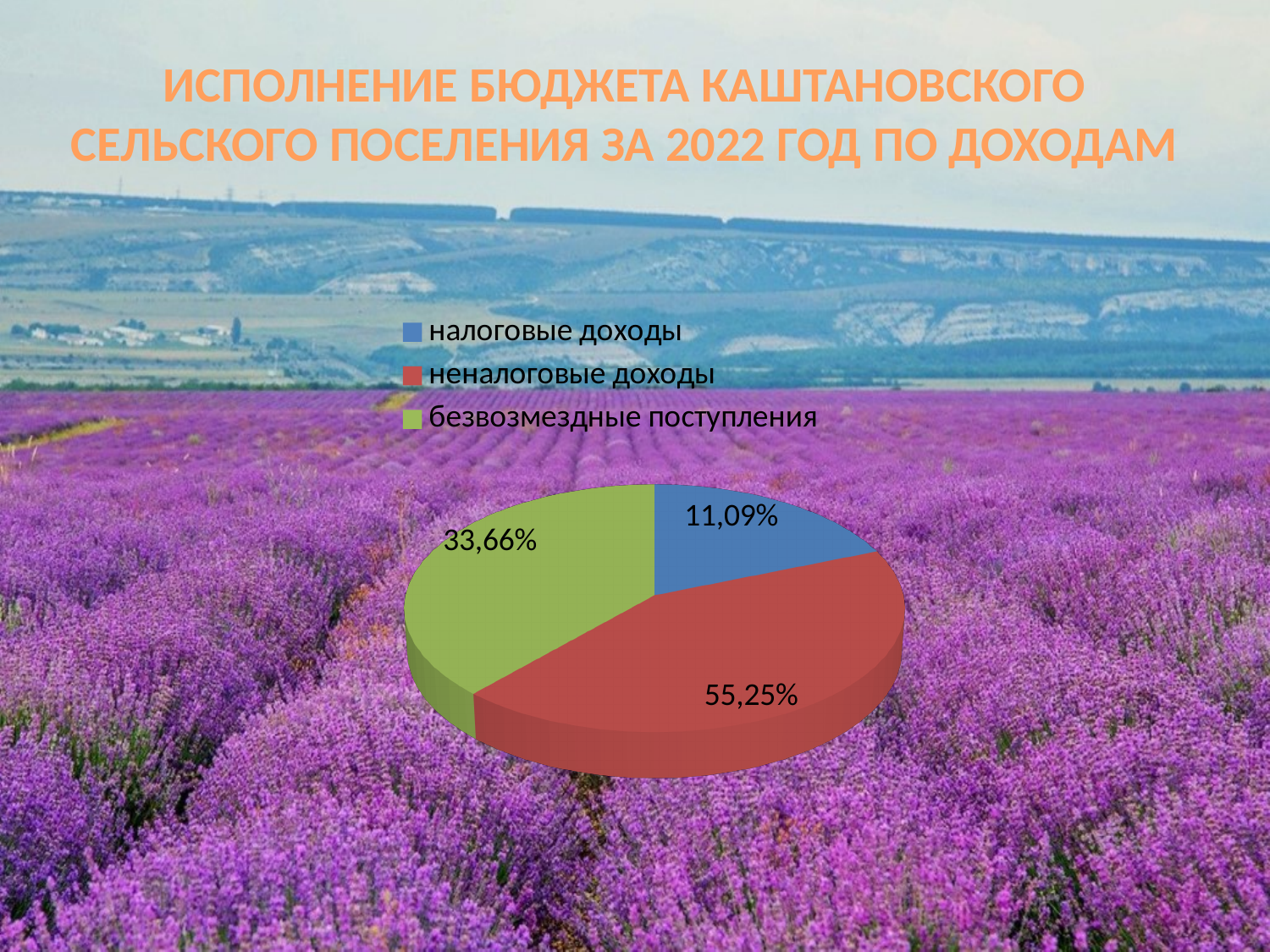
What is the difference in percentage points between неналоговые доходы and безвозмездные поступления? 21,59 Which category has the largest slice of the pie? неналоговые доходы Which category has the smallest slice of the pie? налоговые доходы What share of the pie does налоговые доходы account for? 11,09% What share of the pie does неналоговые доходы account for? 55,25% How many entries does the legend list? 3 Which is larger: the slice for безвозмездные поступления or the slice for налоговые доходы? безвозмездные поступления What share of the pie does безвозмездные поступления account for? 33,66% How many slices does the pie chart have? 3 What is the difference in percentage points between безвозмездные поступления and налоговые доходы? 22,57 Which colour represents неналоговые доходы in the pie chart? red What kind of chart is shown on the slide? pie chart